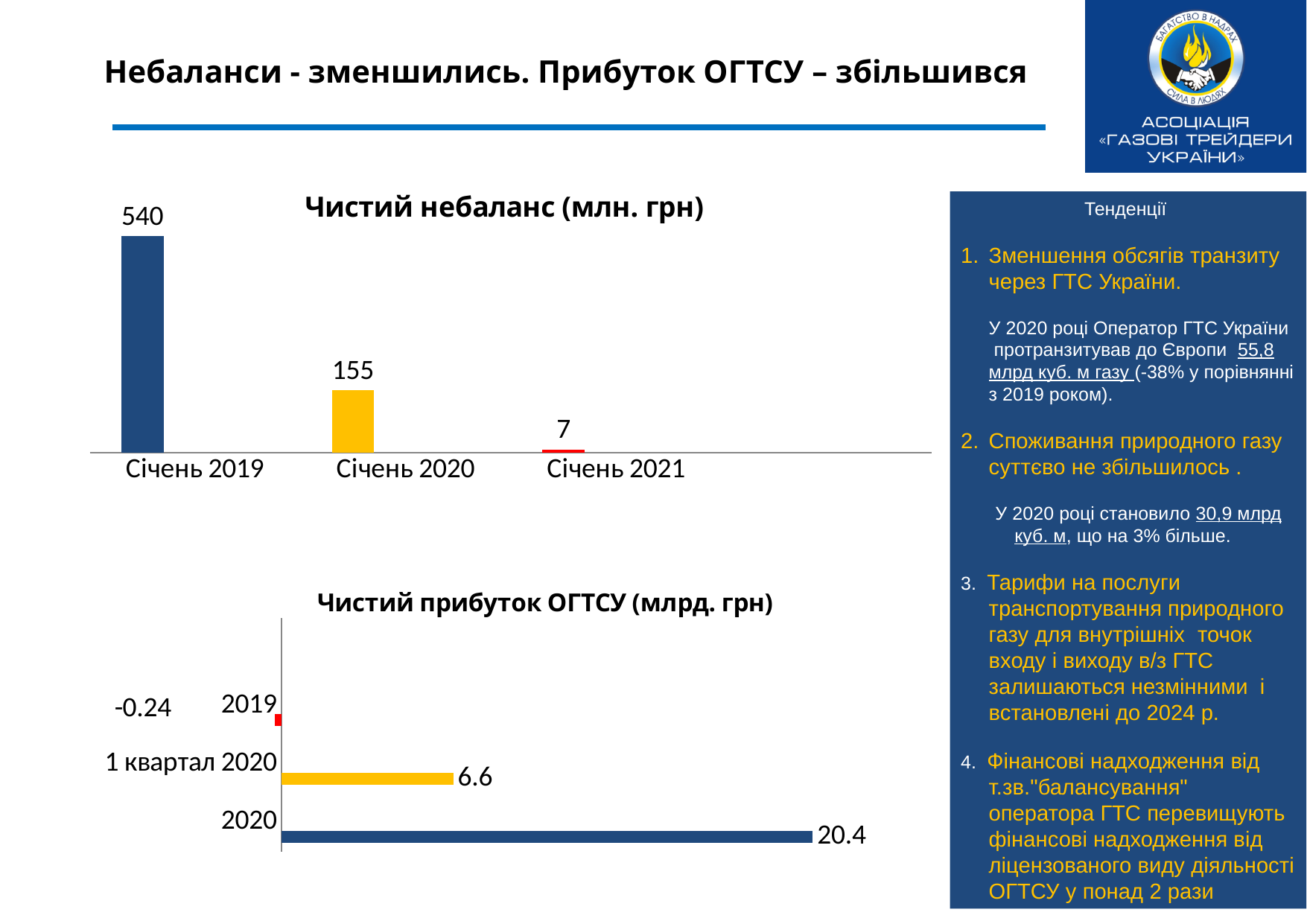
In the chart 'Чистий небаланс (млн. грн)', which category has the highest value? Січень 2019 In the chart 'Чистий небаланс (млн. грн)', what is the value for Січень 2021? 7 In the chart 'Чистий небаланс (млн. грн)', what is the value for Січень 2019? 540 In the chart 'Чистий небаланс (млн. грн)', what is the difference between the values for Січень 2019 and Січень 2020? 385 What type of chart is 'Чистий прибуток ОГТСУ (млрд. грн)'? bar chart In the chart 'Чистий прибуток ОГТСУ (млрд. грн)', what is the difference between the values for 2020 and 1 квартал 2020? 13.8 In the chart 'Чистий прибуток ОГТСУ (млрд. грн)', what is the value for 1 квартал 2020? 6.6 In the chart 'Чистий прибуток ОГТСУ (млрд. грн)', what is the value for 2019? -0.24 In the chart 'Чистий прибуток ОГТСУ (млрд. грн)', which category has the highest value? 2020 In the chart 'Чистий небаланс (млн. грн)', do the values rise or fall from Січень 2019 to Січень 2021? fall How many categories are shown in the chart 'Чистий небаланс (млн. грн)'? 3 In the chart 'Чистий небаланс (млн. грн)', which category has the lowest value? Січень 2021